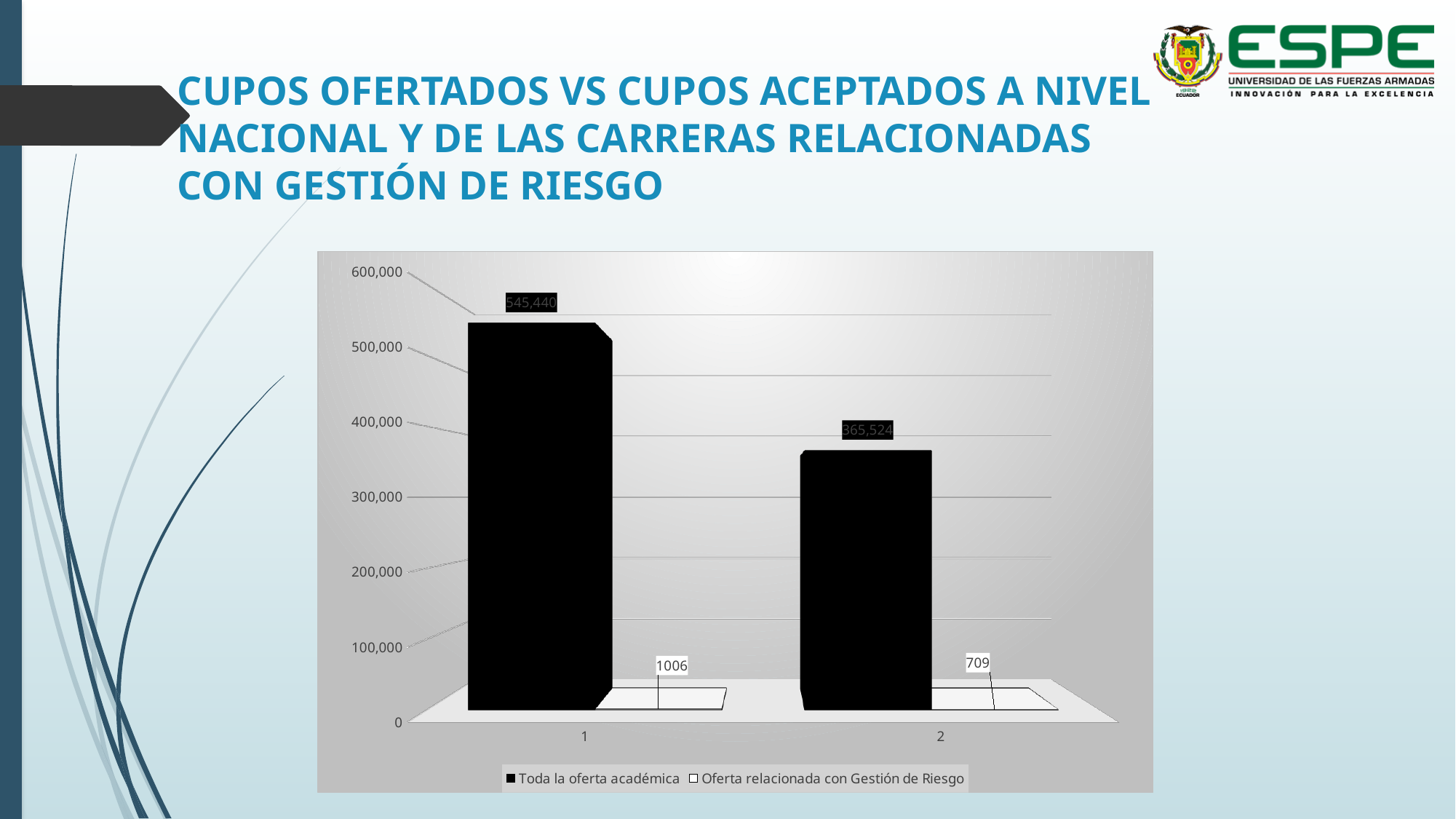
Do the 'Toda la oferta académica' values rise or fall from category 1 to category 2? Fall Which is larger: 'Toda la oferta académica' for category 2 or 'Oferta relacionada con Gestión de Riesgo' for category 1? Toda la oferta académica for category 2 Which category has the lowest value for 'Oferta relacionada con Gestión de Riesgo'? 2 What is the value of 'Toda la oferta académica' for category 2? 365,524 Which category has the highest value for 'Toda la oferta académica'? 1 What kind of chart is shown on the slide? Bar chart What is the difference between the 'Oferta relacionada con Gestión de Riesgo' values for category 1 and category 2? 297 What is the difference between the 'Toda la oferta académica' values for category 1 and category 2? 179,916 What is the value of 'Oferta relacionada con Gestión de Riesgo' for category 2? 709 What is the value of 'Oferta relacionada con Gestión de Riesgo' for category 1? 1006 How many series does the legend list? 2 What is the value of 'Toda la oferta académica' for category 1? 545,440